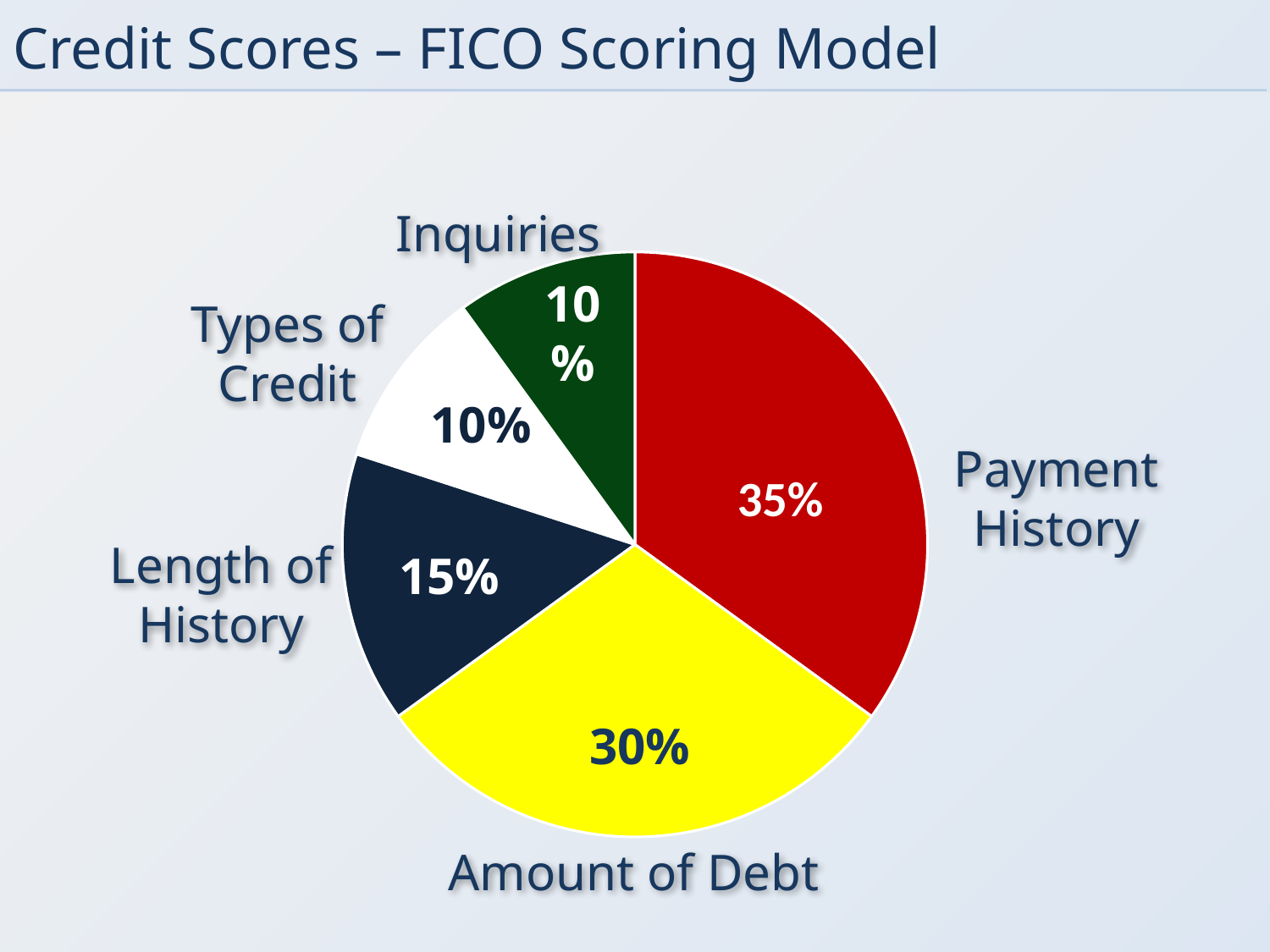
What kind of chart is shown on the slide? pie chart What is the value shown for Length of History? 15% Which is larger, Length of History or Types of Credit? Length of History Which category has the largest slice of the pie? Payment History What is the value shown for Inquiries? 10% What colour is the Amount of Debt slice? yellow What is the difference between the Payment History and Amount of Debt values? 5% What is the value shown for Types of Credit? 10% How many slices does the pie chart have? 5 What share of the pie does Payment History account for? 35% What is the difference between the Amount of Debt and Length of History values? 15% What is the value shown for Amount of Debt? 30%